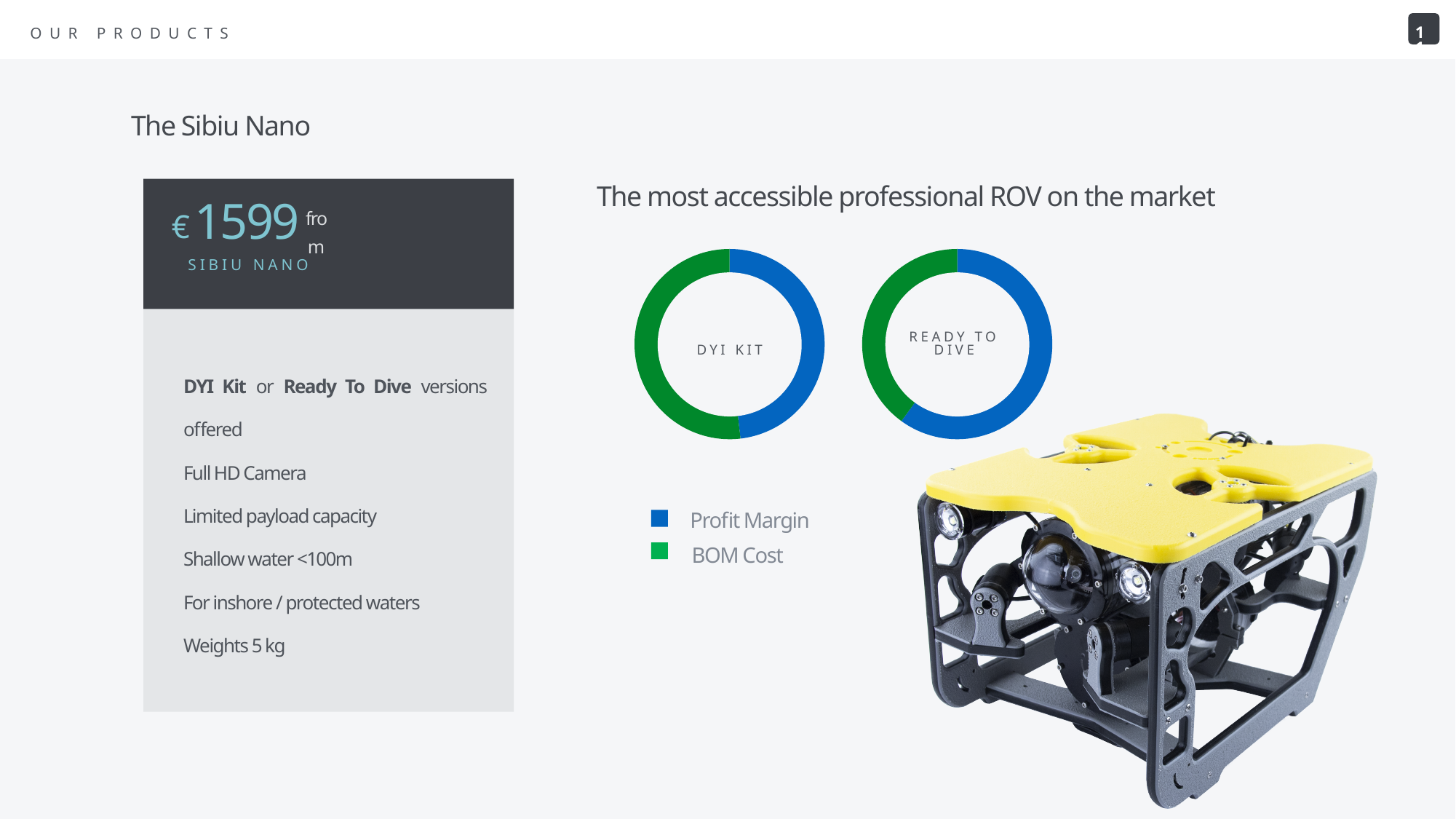
How many entries does the legend shared by the two doughnut charts list? 2 How many doughnut charts are shown on the slide? 2 How many slices does each doughnut chart have? 2 What colour represents Profit Margin in the doughnut charts? Blue In the "READY TO DIVE" chart, which slice is larger, Profit Margin or BOM Cost? Profit Margin In the "READY TO DIVE" chart, which category has the largest slice? Profit Margin Which chart shows a larger Profit Margin share, "DYI KIT" or "READY TO DIVE"? READY TO DIVE In the "READY TO DIVE" chart, which category has the smallest slice? BOM Cost What kind of chart is the "DYI KIT" chart? Doughnut chart Which chart shows a larger BOM Cost share, "DYI KIT" or "READY TO DIVE"? DYI KIT What kind of chart is the "READY TO DIVE" chart? Doughnut chart What colour represents BOM Cost in the doughnut charts? Green